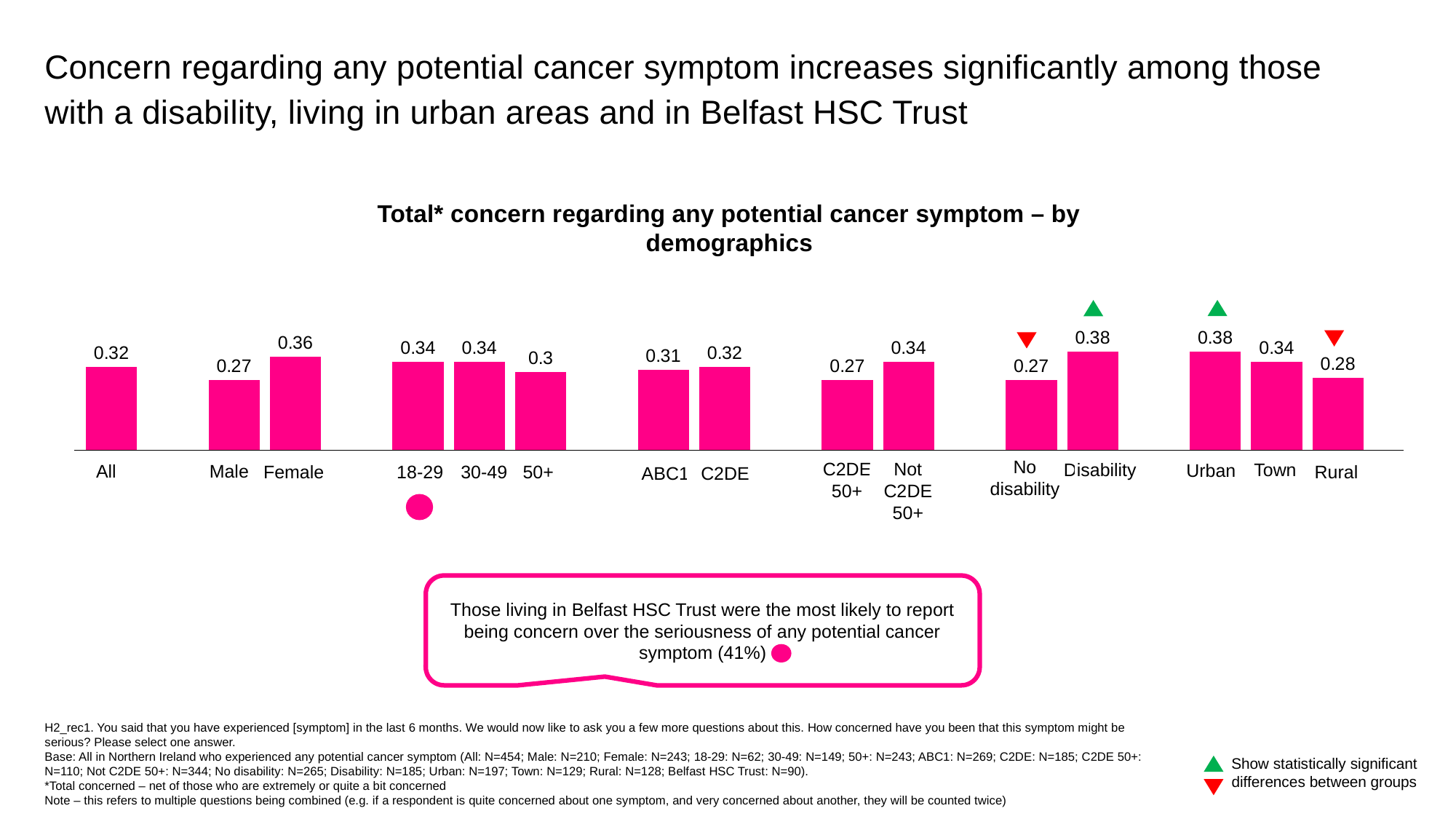
What is the difference between the values for Female and Male? 0.09 What is the value for Female in the chart? 0.36 What is the value for Rural in the chart? 0.28 What is the difference between the values for Disability and No disability? 0.11 What is the value for 50+ in the chart? 0.3 What type of chart is shown on the slide? Bar chart How many bars are plotted in the chart? 15 What is the difference between the values for Urban and Rural? 0.1 What is the value for Disability in the chart? 0.38 What is the value for the All category in the chart? 0.32 Which has a higher value, ABC1 or C2DE? C2DE Which has a higher value, C2DE 50+ or Not C2DE 50+? Not C2DE 50+